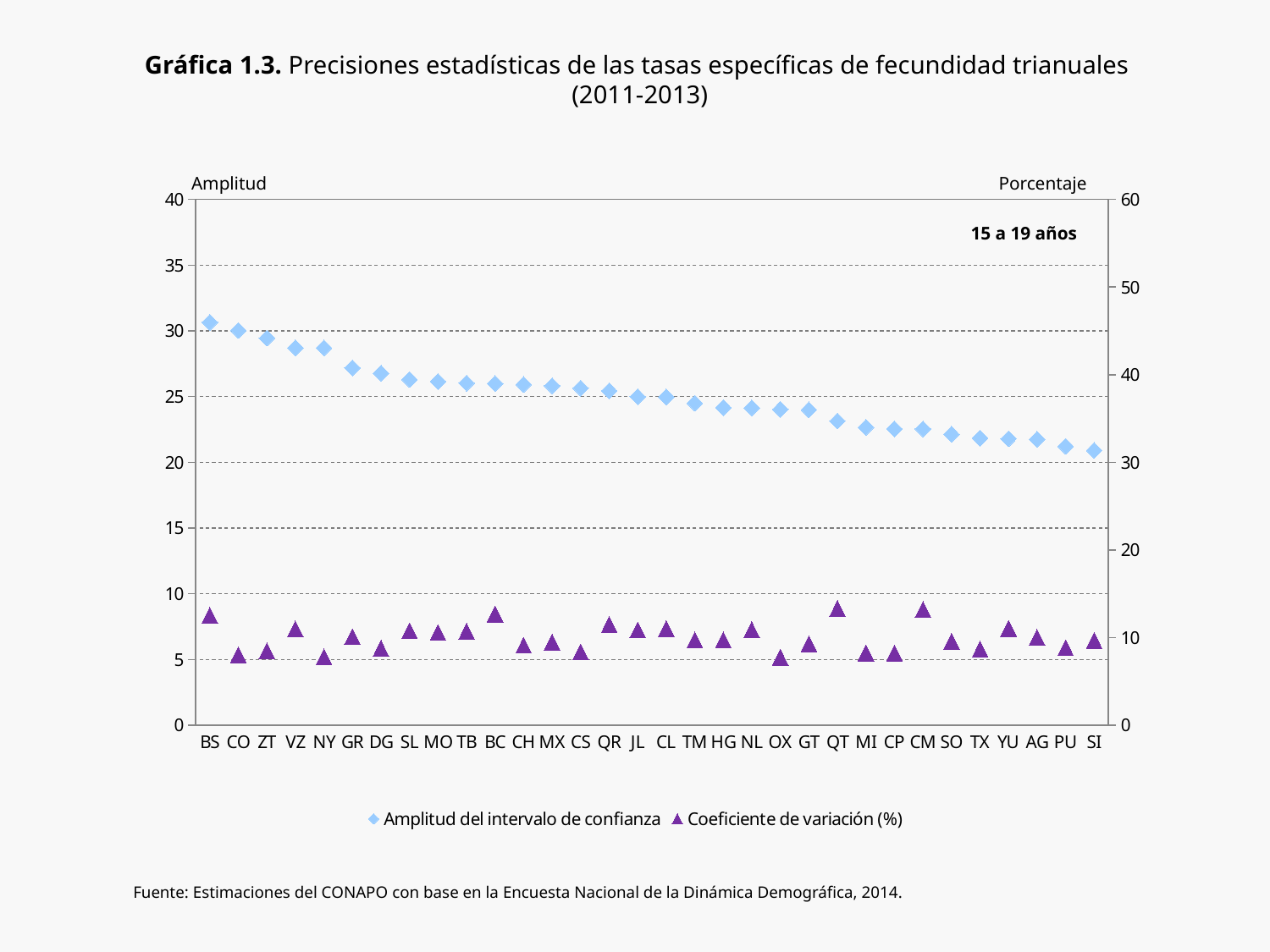
Is the Amplitud del intervalo de confianza value for SI greater or less than 25 on the left axis? less What kind of chart is shown on the slide? scatter chart What is the title of the right-hand vertical axis? Porcentaje Do the values for Amplitud del intervalo de confianza rise or fall from BS to SI along the x axis? fall Is the Coeficiente de variación (%) value for QT greater or less than 10 on the right axis? greater How many categories (states) are shown along the x axis? 32 Which category has the highest value for Amplitud del intervalo de confianza? BS Is the Amplitud del intervalo de confianza value for BS greater or less than 25 on the left axis? greater What age group label is shown inside the plot area? 15 a 19 años Which category has the lowest value for Amplitud del intervalo de confianza? SI How many series does the legend list? 2 Which has the larger Coeficiente de variación (%), QT or CO? QT